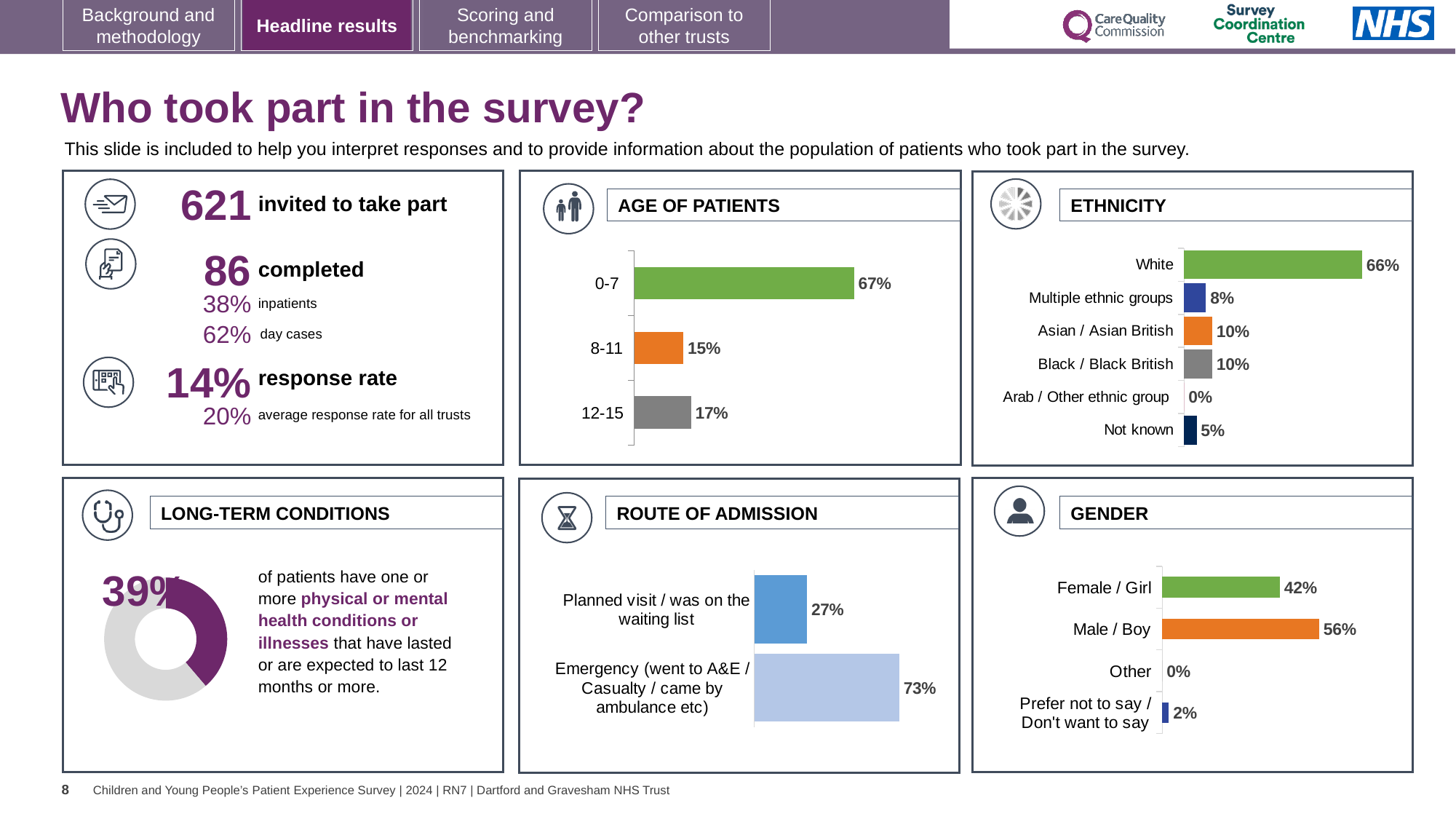
How many categories are shown in the ETHNICITY chart? 6 In the ETHNICITY chart, which is larger: Multiple ethnic groups or Not known? Multiple ethnic groups In the ETHNICITY chart, which category has the highest percentage? White In the ETHNICITY chart, what percentage of patients were Asian / Asian British? 10% In the AGE OF PATIENTS chart, what percentage of patients were aged 0-7? 67% In the AGE OF PATIENTS chart, which age group has the lowest percentage? 8-11 In the GENDER chart, which is larger: Female / Girl or Male / Boy? Male / Boy In the ROUTE OF ADMISSION chart, what percentage of patients came via Emergency (went to A&E / Casualty / came by ambulance etc)? 73% In the AGE OF PATIENTS chart, what is the difference between the 0-7 and 12-15 percentages? 50% In the ROUTE OF ADMISSION chart, what is the difference between the Emergency and Planned visit percentages? 46% In the GENDER chart, what percentage of patients were Male / Boy? 56% What type of chart is used in the LONG-TERM CONDITIONS panel? Doughnut chart